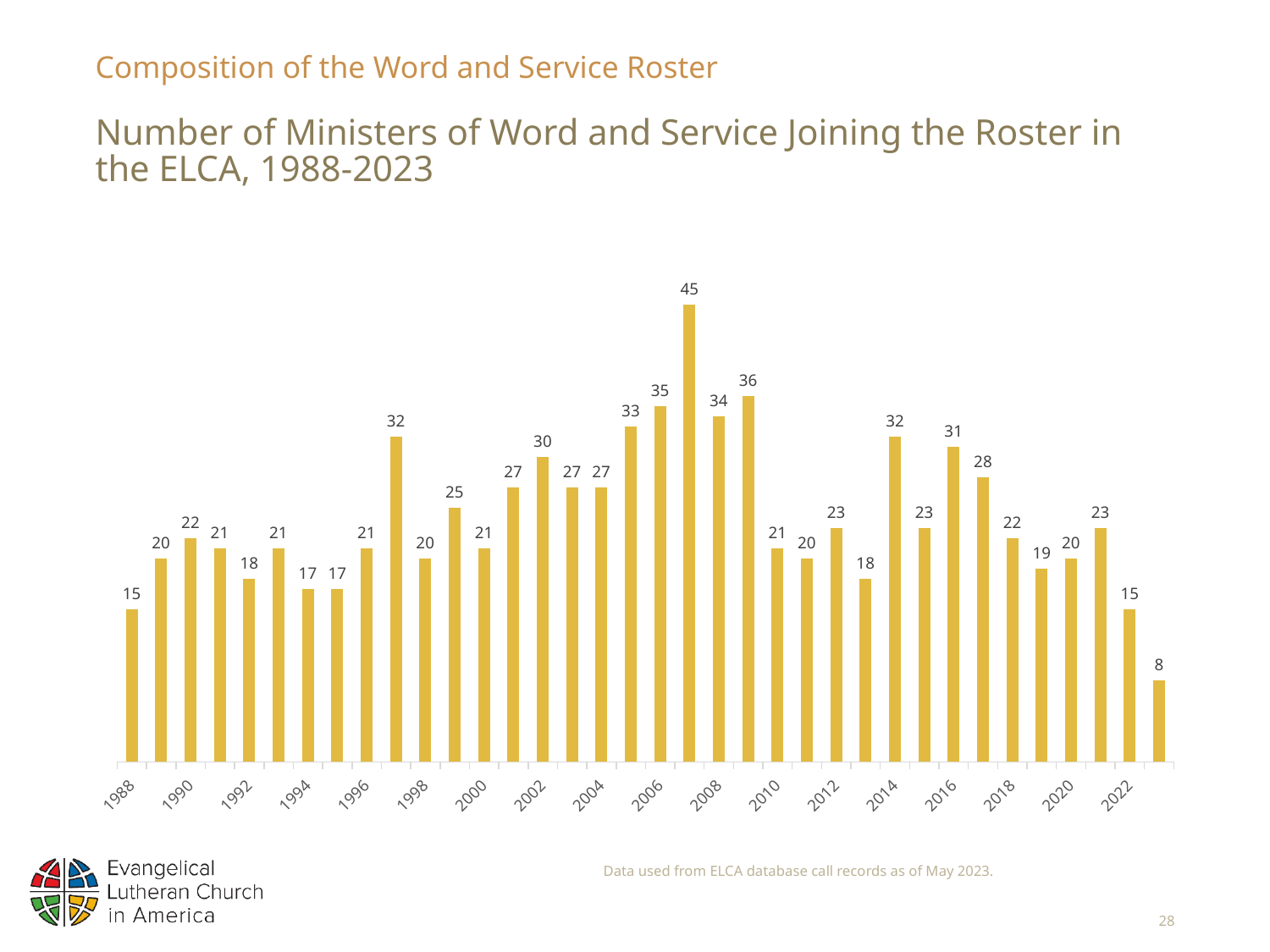
Which year has the larger value, 2006 or 2010? 2006 What is the value for 1988? 15 What kind of chart is shown on the slide? bar chart What is the value for 2002? 30 What is the value for 2014? 32 What is the difference between the values for 2016 and 2018? 9 What is the value for 2022? 15 Do the values rise or fall from 2018 to 2023? fall What is the difference between the values for 1990 and 2020? 2 What is the title of the chart? Number of Ministers of Word and Service Joining the Roster in the ELCA, 1988-2023 What is the lowest value shown on the chart? 8 What is the highest value shown on the chart? 45